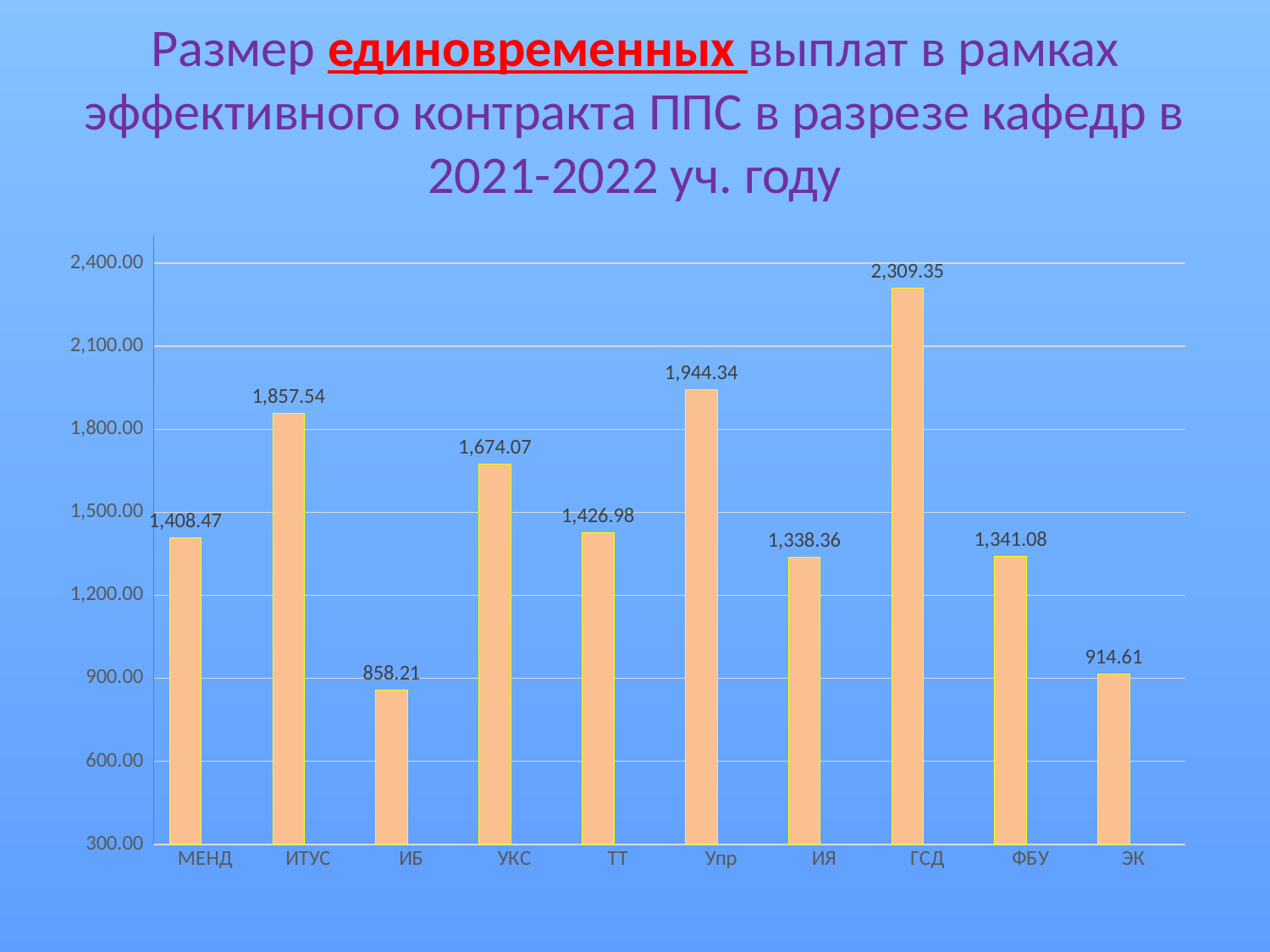
What is the value for ГСД? 2,309.35 What is the value for ИБ? 858.21 Is the value for ЭК greater or less than 1,200.00? less How many departments are shown on the x axis? 10 What is the value for Упр? 1,944.34 What is the difference between the values for ИТУС and МЕНД? 449.07 What is the difference between the values for ГСД and ИБ? 1,451.14 Which department has the lowest value? ИБ Which is larger, the value for УКС or the value for ТТ? УКС What kind of chart is shown on the slide? bar chart Which department has the highest value? ГСД What is the value for ФБУ? 1,341.08